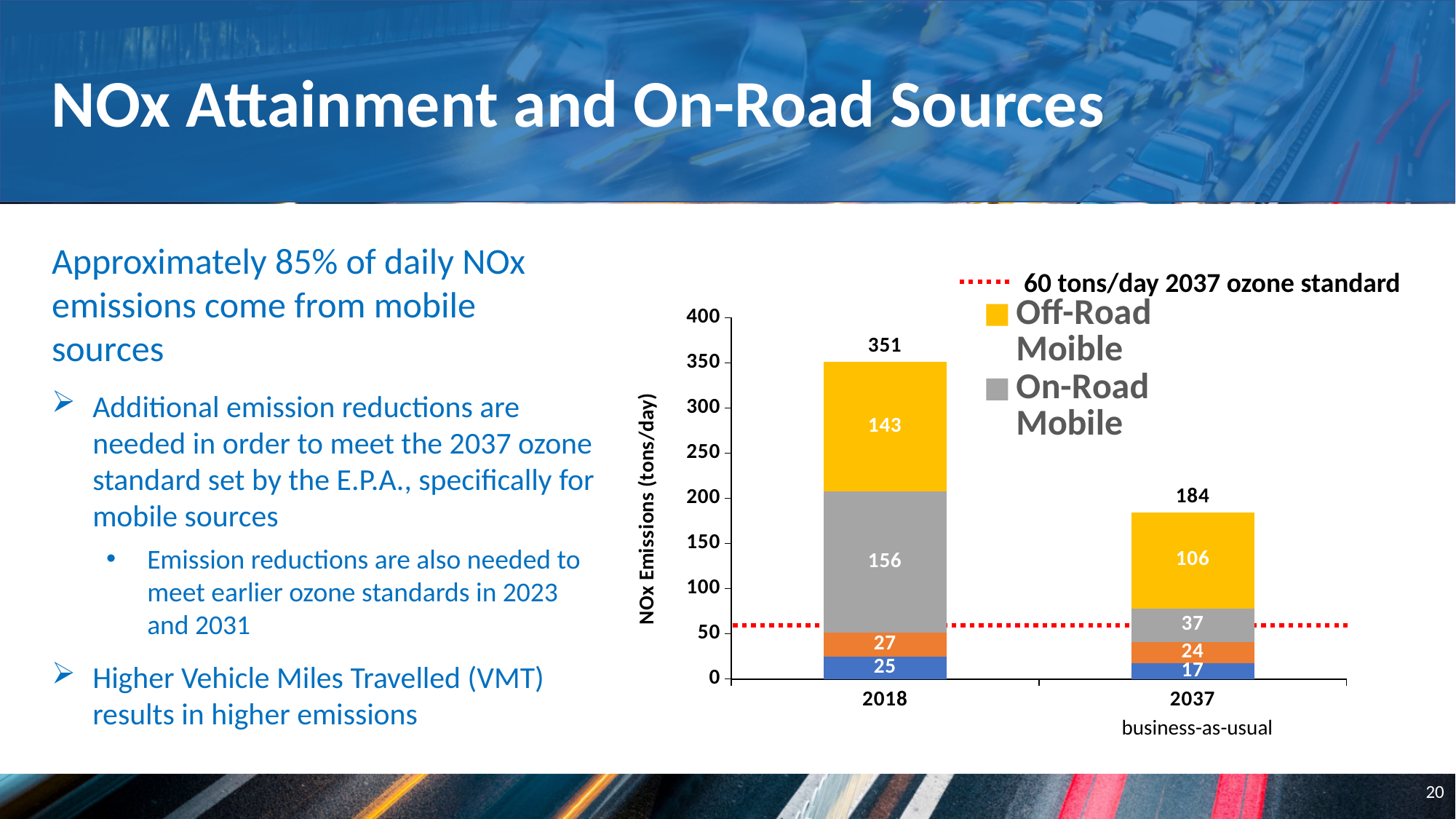
How many years (categories) are plotted on the x axis? 2 What value does the red dotted line represent? 60 tons/day 2037 ozone standard What is the total NOx emissions shown for the 2037 bar? 184 What is the Off-Road Mobile value for 2018? 143 What is the On-Road Mobile value for 2018? 156 What is the total NOx emissions shown for the 2018 bar? 351 What is the difference between the 2018 total and the 2037 total? 167 By how much does the On-Road Mobile value decrease from 2018 to 2037? 119 What is the On-Road Mobile value for 2037? 37 In 2037, which is larger: Off-Road Mobile or On-Road Mobile? Off-Road Mobile What is the Off-Road Mobile value for 2037? 106 What kind of chart is shown on the slide? Stacked bar chart